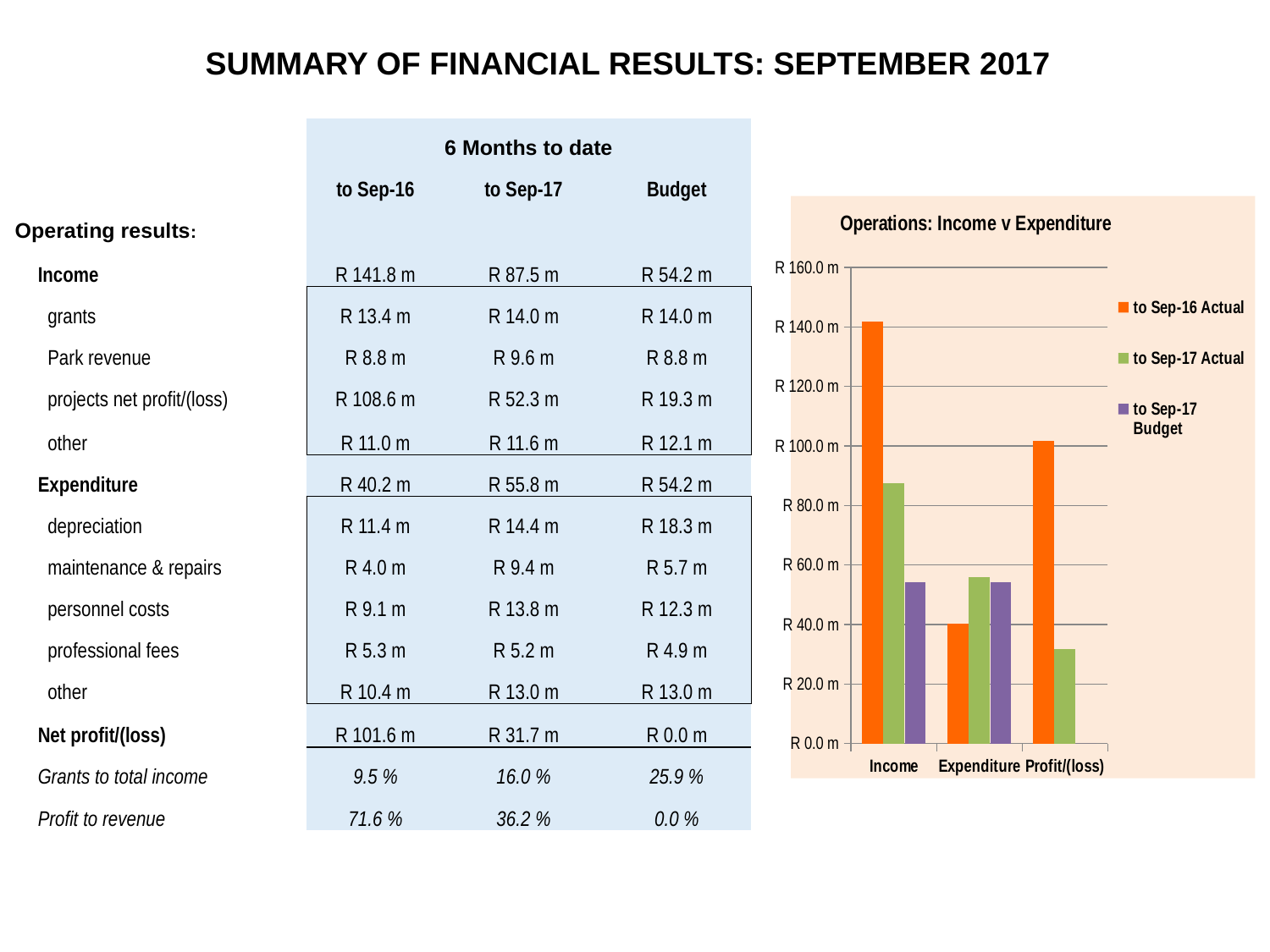
Which category has the lowest to Sep-16 Actual bar? Expenditure What colour are the to Sep-16 Actual bars in the chart? orange How many series does the legend of the chart list? 3 What is the title of the chart? Operations: Income v Expenditure Is the to Sep-16 Actual value for Profit/(loss) greater or less than R 80.0 m? greater For Expenditure, which is larger: to Sep-16 Actual or to Sep-17 Actual? to Sep-17 Actual How many categories are shown on the x axis of the chart? 3 Is the to Sep-16 Actual value for Expenditure greater or less than R 60.0 m? less Which category has the highest to Sep-16 Actual bar? Income For Income, which is larger: to Sep-16 Actual or to Sep-17 Actual? to Sep-16 Actual Is the to Sep-16 Actual value for Income greater or less than R 120.0 m? greater What kind of chart is shown on the slide? bar chart